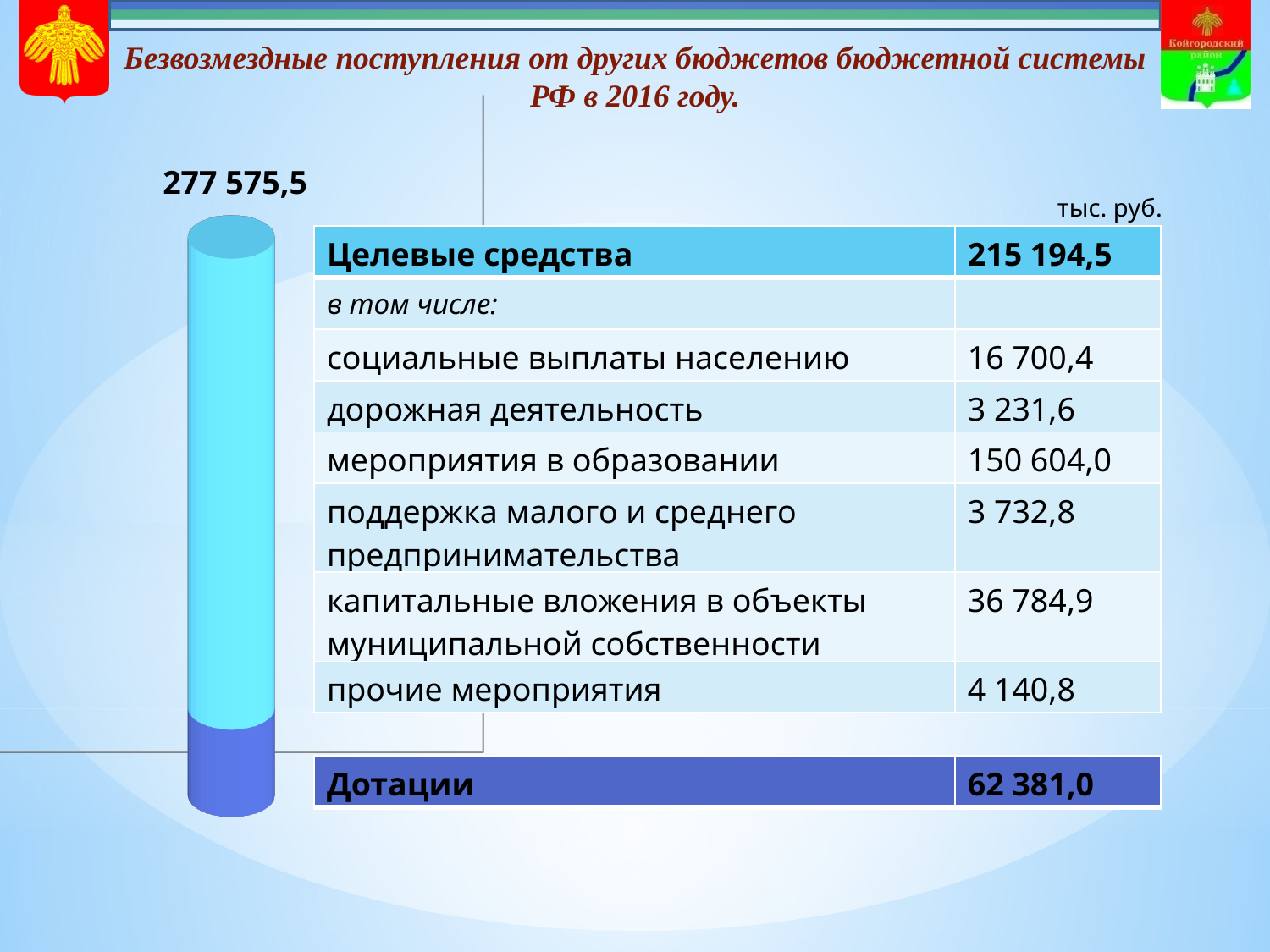
What is the difference between the Целевые средства and Дотации values? 152 813,5 Which segment is shown in dark blue at the bottom of the bar? Дотации Which segment of the bar is the smallest? Дотации What kind of chart is shown on the slide? Stacked bar chart Which segment of the bar is larger, Целевые средства or Дотации? Целевые средства How many segments make up the stacked bar? 2 Is the value of the Дотации segment greater or less than 100 000? less What is the value of the Дотации segment of the bar? 62 381,0 What is the value of the Целевые средства segment of the bar? 215 194,5 What unit of measurement is indicated for the values on the slide? тыс. руб. What is the total value shown at the top of the stacked bar? 277 575,5